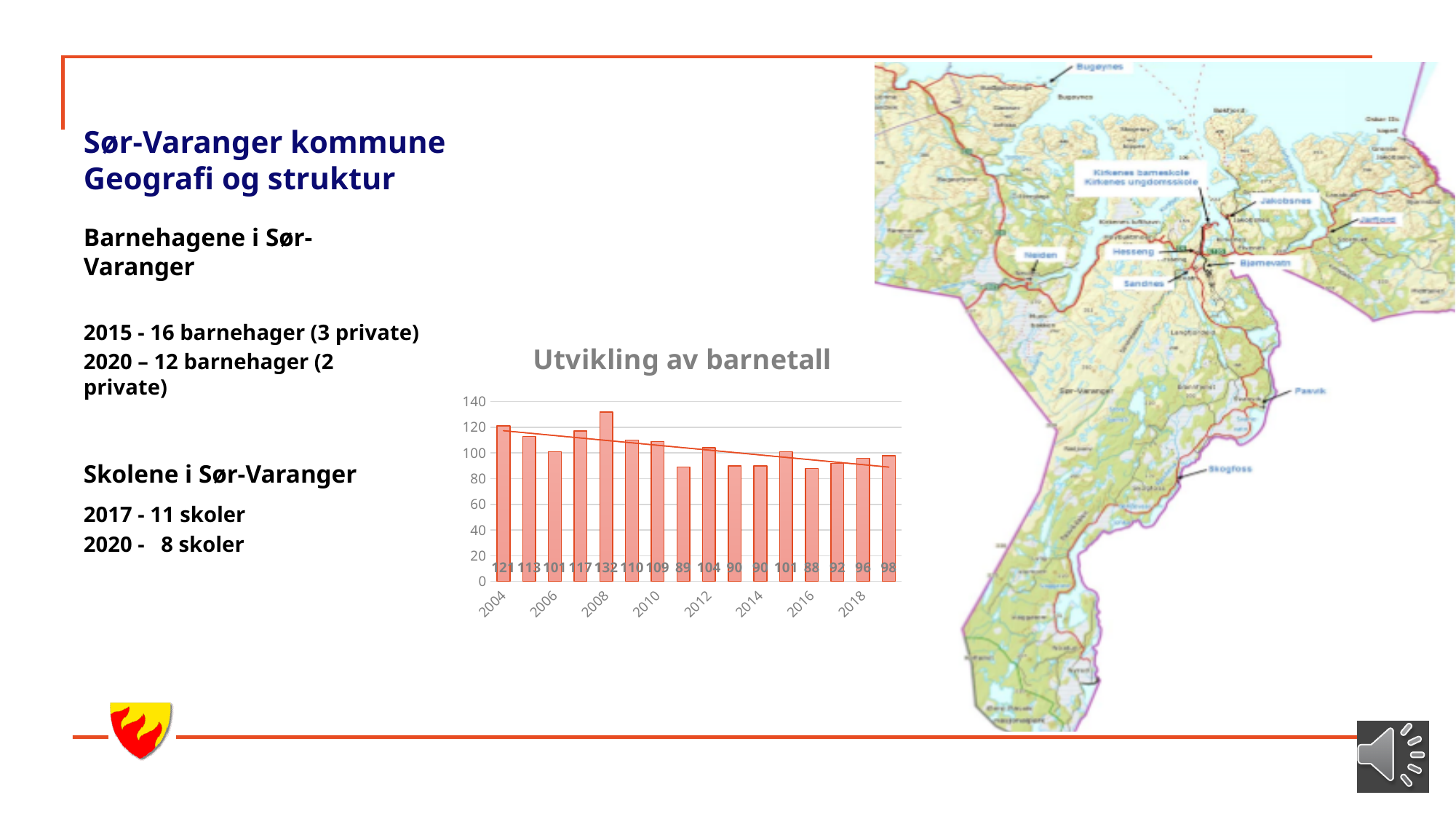
How many bars are plotted in the 'Utvikling av barnetall' chart? 16 In the 'Utvikling av barnetall' chart, what is the value for 2018? 96 In the 'Utvikling av barnetall' chart, which year has the lowest value? 2016 What is the title of the chart on the slide? Utvikling av barnetall In the 'Utvikling av barnetall' chart, what is the value for 2004? 121 In the 'Utvikling av barnetall' chart, which year has the larger value, 2010 or 2012? 2010 In the 'Utvikling av barnetall' chart, is the value for 2014 greater or less than 100? less In the 'Utvikling av barnetall' chart, what is the difference between the values for 2004 and 2018? 25 In the 'Utvikling av barnetall' chart, which year has the highest value? 2008 In the 'Utvikling av barnetall' chart, what is the value for 2008? 132 What kind of chart is 'Utvikling av barnetall'? bar chart In the 'Utvikling av barnetall' chart, do the values generally rise or fall from 2004 to the last year shown? fall